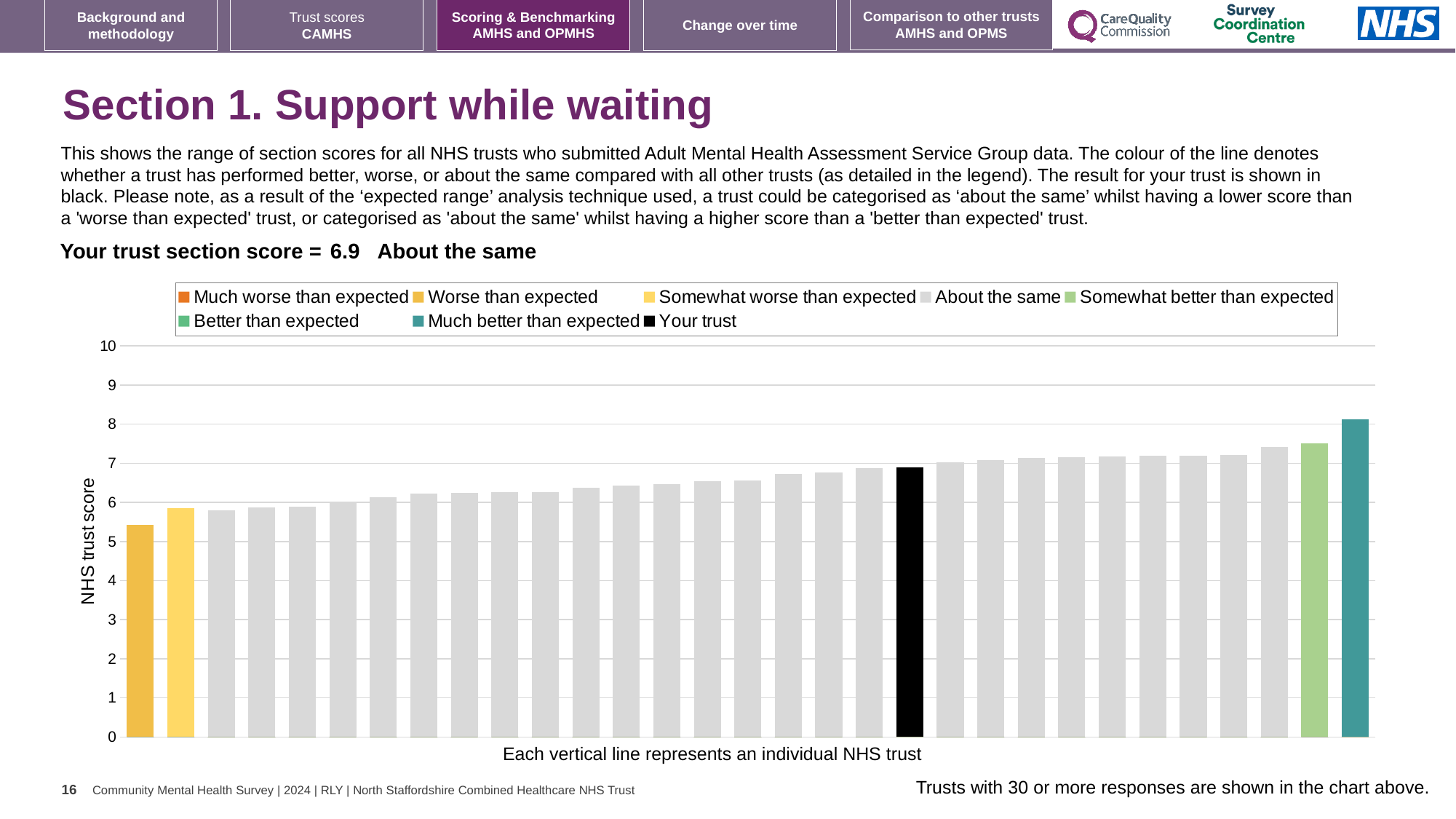
Is the 'Somewhat better than expected' bar higher or lower than the 'Your trust' bar? higher Is the value of the teal 'Much better than expected' bar greater or less than 7? greater How many entries does the chart legend list? 8 What kind of chart is shown on the slide? bar chart Is the value of the leftmost bar greater or less than 6? less Which performance category is your trust placed in for this section? About the same Is the value of the black 'Your trust' bar greater or less than 6? greater Which legend category does the tallest bar in the chart belong to? Much better than expected What is the label on the vertical axis of the chart? NHS trust score Which legend category does the shortest bar in the chart belong to? Worse than expected What is the section score for your trust shown on the slide? 6.9 Do the bar values rise or fall from left to right along the x axis? rise